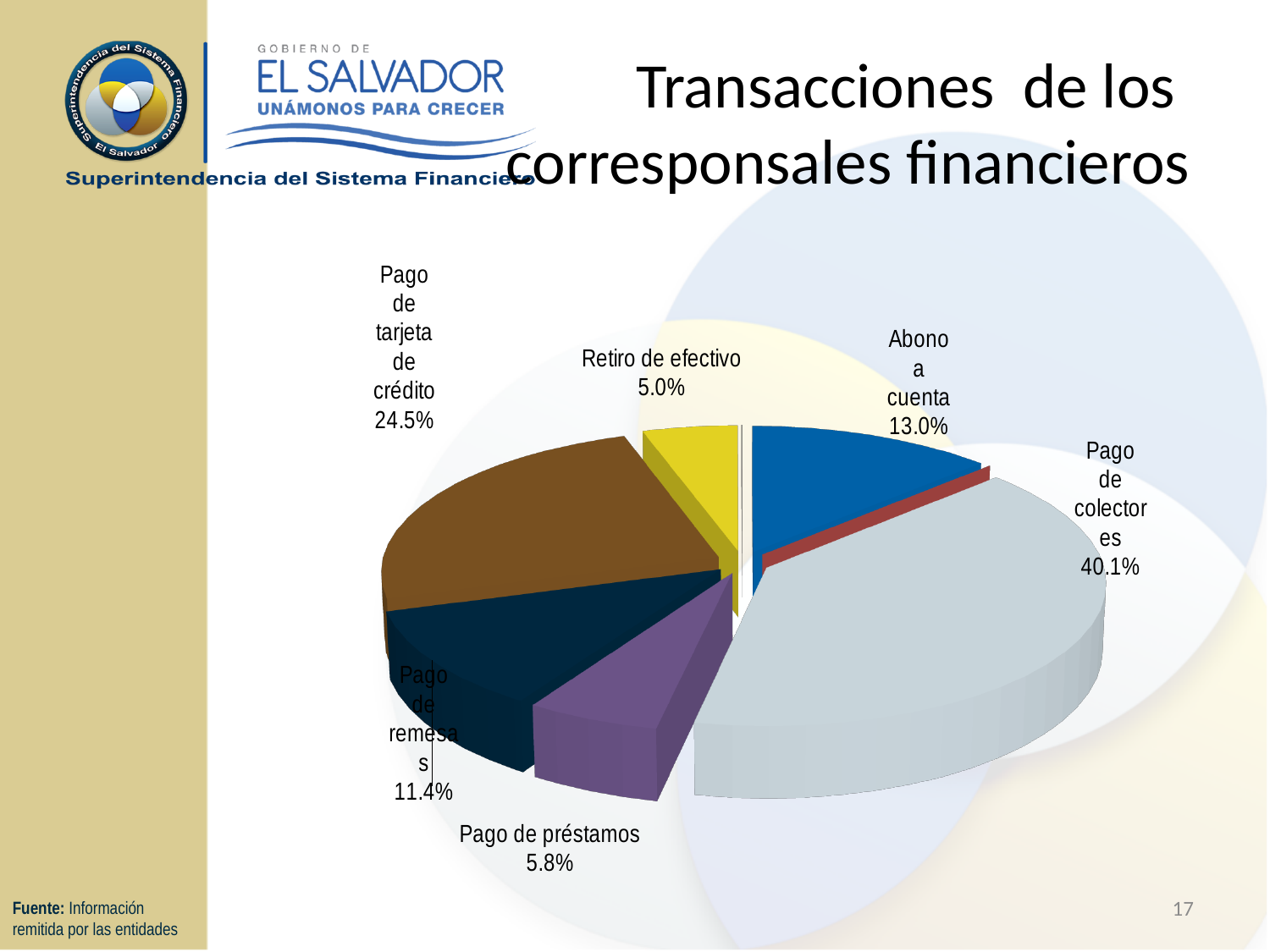
What kind of chart is shown on the slide? pie chart What share of transactions is Abono a cuenta? 13.0% What share of transactions is Pago de tarjeta de crédito? 24.5% What is the difference in percentage points between Pago de colectores and Pago de tarjeta de crédito? 15.6 Which transaction type has the largest share of the pie? Pago de colectores What share of transactions is Pago de colectores? 40.1% What share of transactions is Retiro de efectivo? 5.0% What is the title of the slide containing the chart? Transacciones de los corresponsales financieros What share of transactions is Pago de remesas? 11.4% Which is larger, Abono a cuenta or Pago de remesas? Abono a cuenta